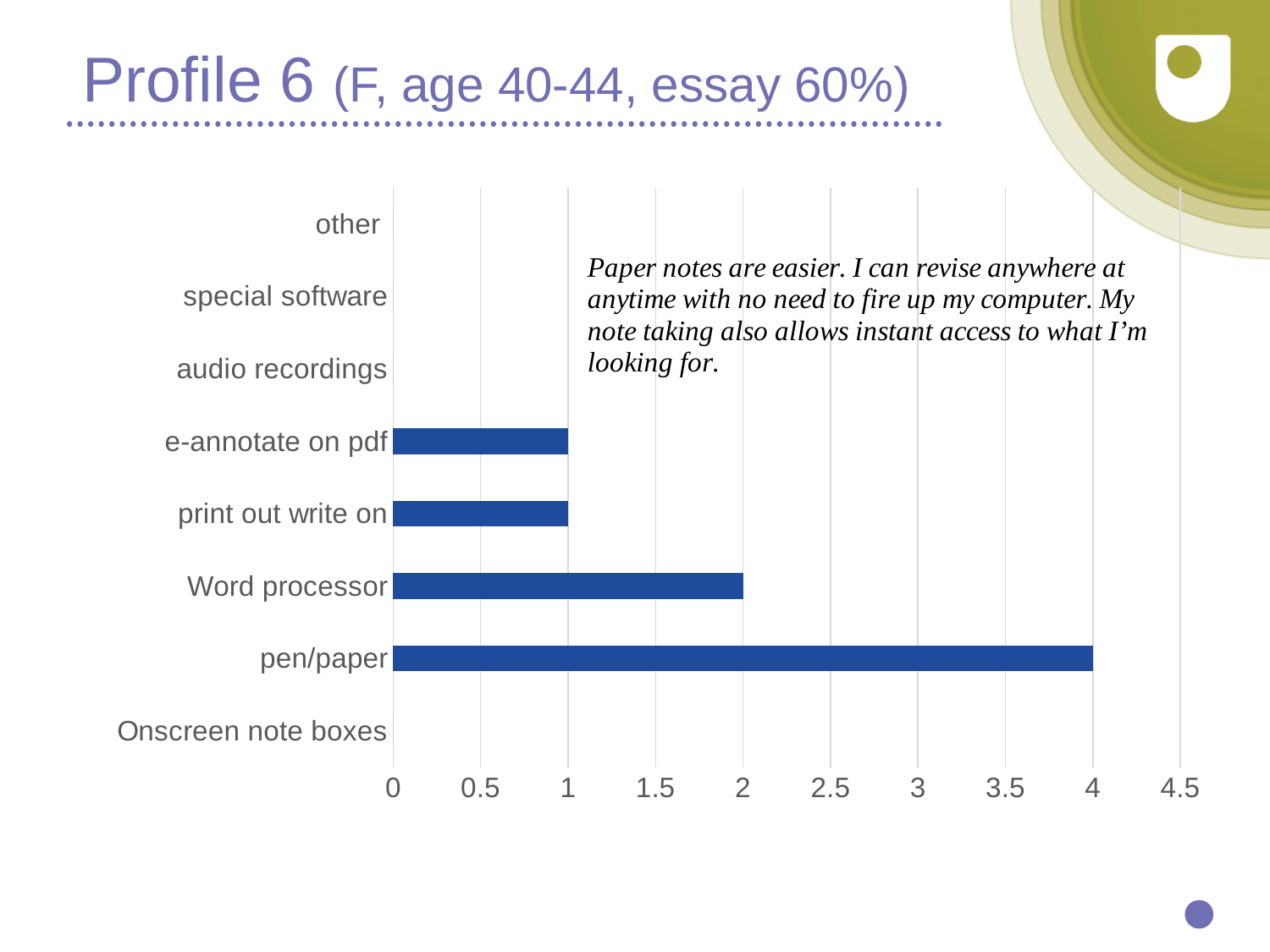
Is the value for pen/paper greater or less than 3? greater What is the value for print out write on? 1 Which category has the highest value in the chart? pen/paper What is the value for Word processor? 2 What is the highest value shown on the horizontal axis of the chart? 4.5 What is the value for e-annotate on pdf? 1 What is the difference between the values for pen/paper and Word processor? 2 How many categories are listed on the vertical axis of the chart? 8 What kind of chart is shown on the slide? bar chart Which is larger, the value for Word processor or the value for e-annotate on pdf? Word processor What is the value for pen/paper? 4 How many categories in the chart have a visible bar? 4